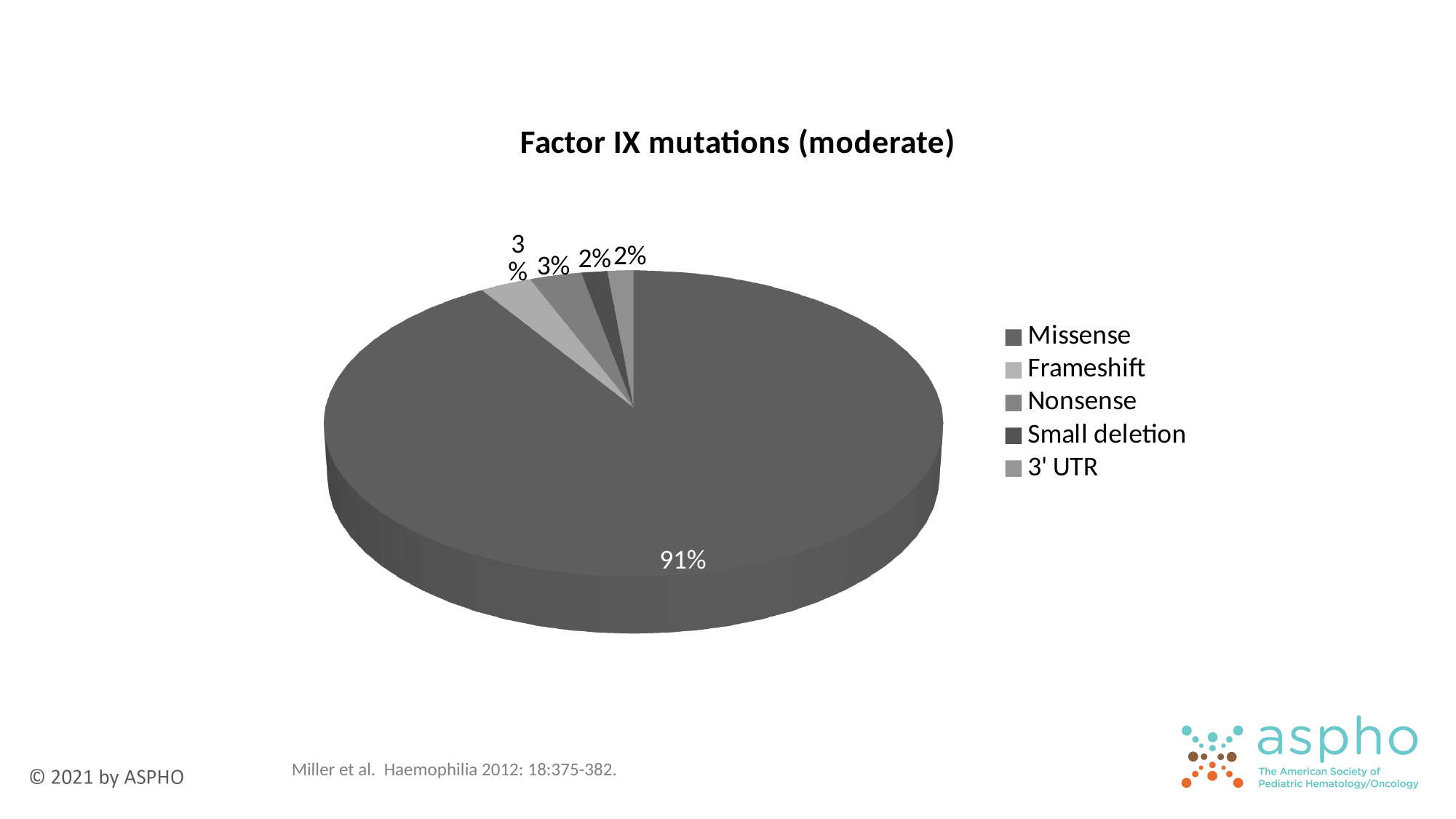
How many mutation categories does the legend list? 5 Which is larger, the share for Missense or the share for Frameshift? Missense What is the title of the chart? Factor IX mutations (moderate) Which mutation type has the largest share of the pie? Missense What kind of chart is shown on the slide? pie chart What percentage is shown for Small deletion? 2% What percentage of Factor IX mutations (moderate) are Missense? 91% What percentage is shown for 3' UTR? 2% What is the difference between the Missense share and the Nonsense share? 88% What share of the pie is Nonsense? 3% What share of the pie is Frameshift? 3%